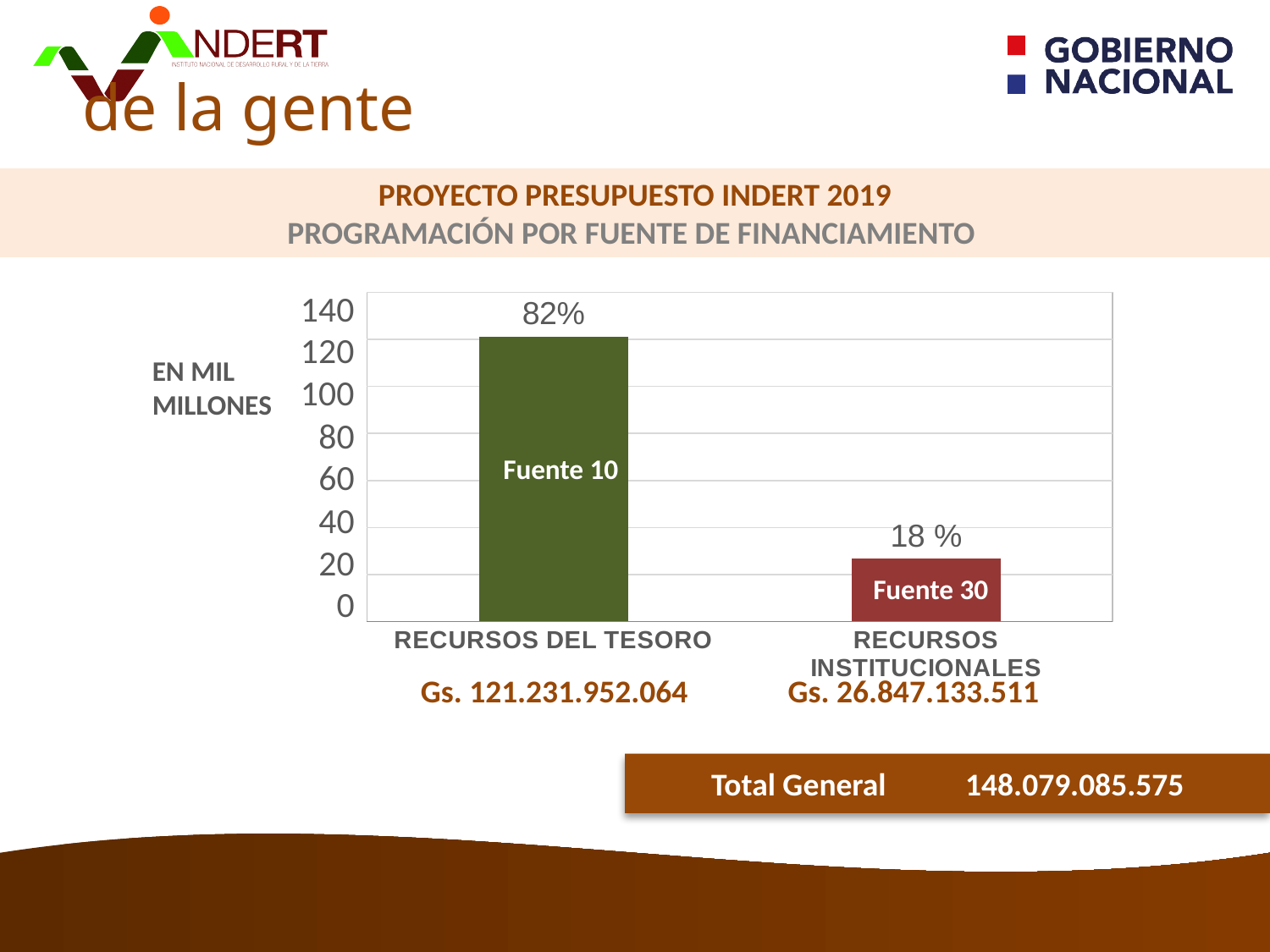
What amount in guaraníes is shown for RECURSOS INSTITUCIONALES? Gs. 26.847.133.511 Is the value for RECURSOS DEL TESORO greater or less than 100? greater What percentage label is shown above the RECURSOS DEL TESORO bar? 82% What amount in guaraníes is shown for RECURSOS DEL TESORO? Gs. 121.231.952.064 What is the Total General shown below the chart? 148.079.085.575 What percentage label is shown above the RECURSOS INSTITUCIONALES bar? 18 % Which category has the lowest value? RECURSOS INSTITUCIONALES Is the value for RECURSOS INSTITUCIONALES greater or less than 40? less What kind of chart is shown on the slide? bar chart What is the difference in guaraníes between RECURSOS DEL TESORO and RECURSOS INSTITUCIONALES? 94.384.818.553 Which category has the highest value? RECURSOS DEL TESORO How many categories are plotted in the chart? 2